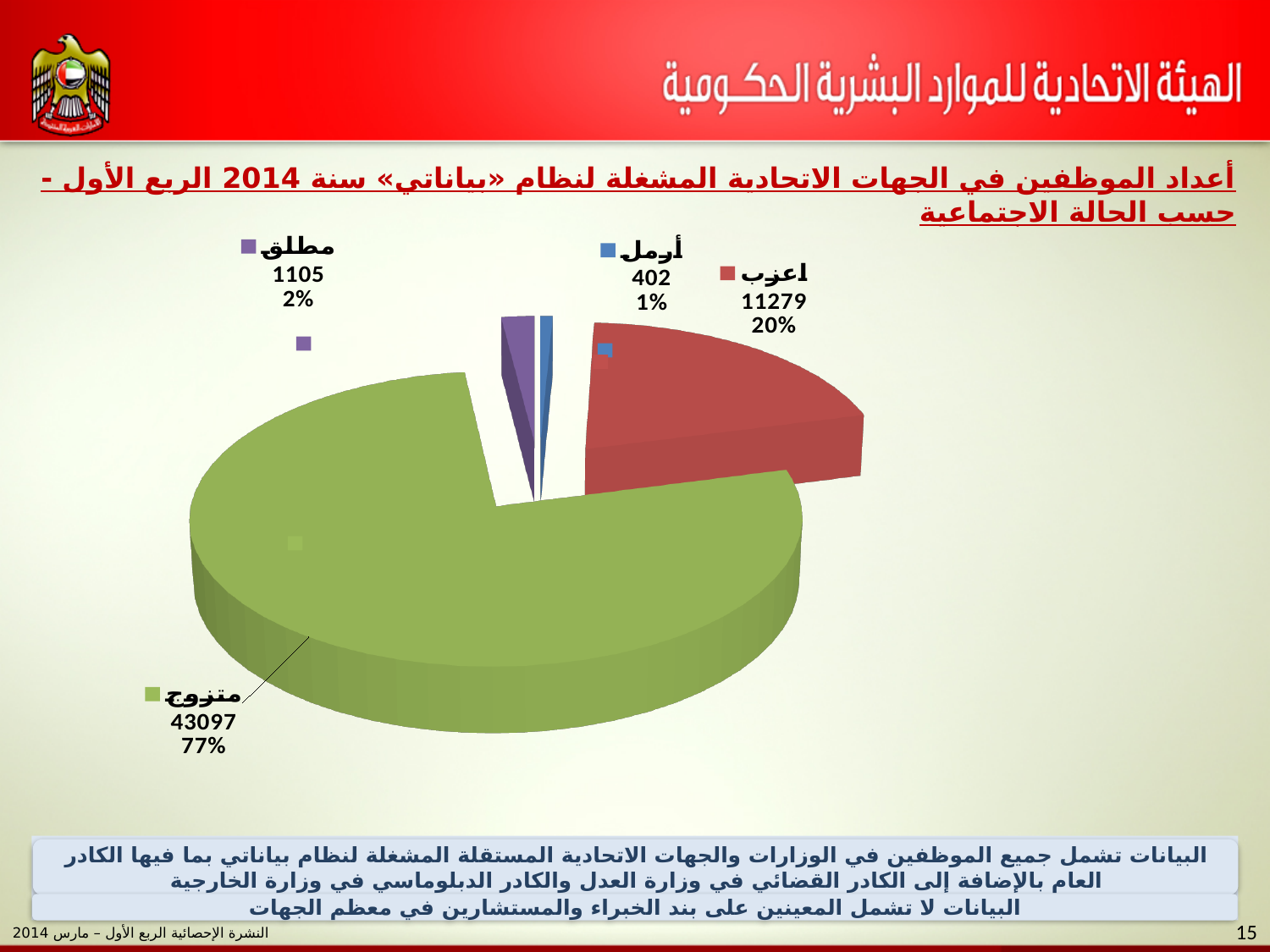
What is the number of employees in the أرمل (widowed) category? 402 What is the difference between the number of متزوج (married) employees and أعزب (single) employees? 31818 Which category has the smallest share of the pie? أرمل How many categories (slices) does the pie chart show? 4 What percentage share of the pie does the مطلق (divorced) slice represent? 2% What is the number of employees in the متزوج (married) category? 43097 Which is larger, the number of مطلق (divorced) employees or the number of أرمل (widowed) employees? مطلق What kind of chart is shown on the slide? Pie chart What is the number of employees in the مطلق (divorced) category? 1105 Which category has the largest share of the pie? متزوج What is the number of employees in the أعزب (single) category? 11279 What percentage share of the pie does the أعزب (single) slice represent? 20%